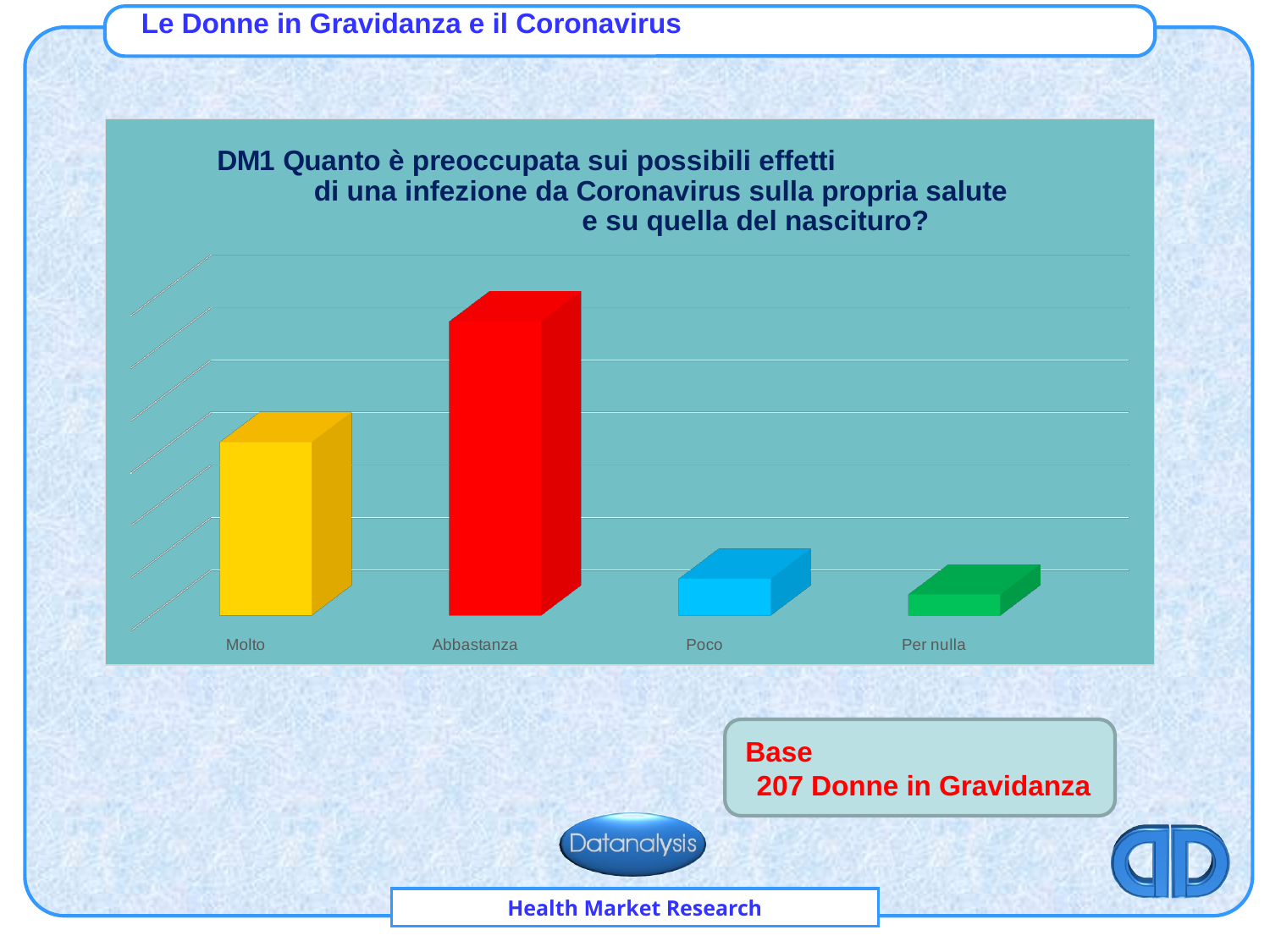
How many categories are shown on the x axis of the chart? 4 What colour is the bar for Abbastanza? Red Which is larger, the bar for Abbastanza or the bar for Molto? Abbastanza Which category has the highest bar in the chart? Abbastanza Which is larger, the bar for Poco or the bar for Per nulla? Poco What is the label of the first category on the x axis? Molto What kind of chart is shown on the slide? Bar chart Which category has the lowest bar in the chart? Per nulla Which is larger, the bar for Molto or the bar for Poco? Molto